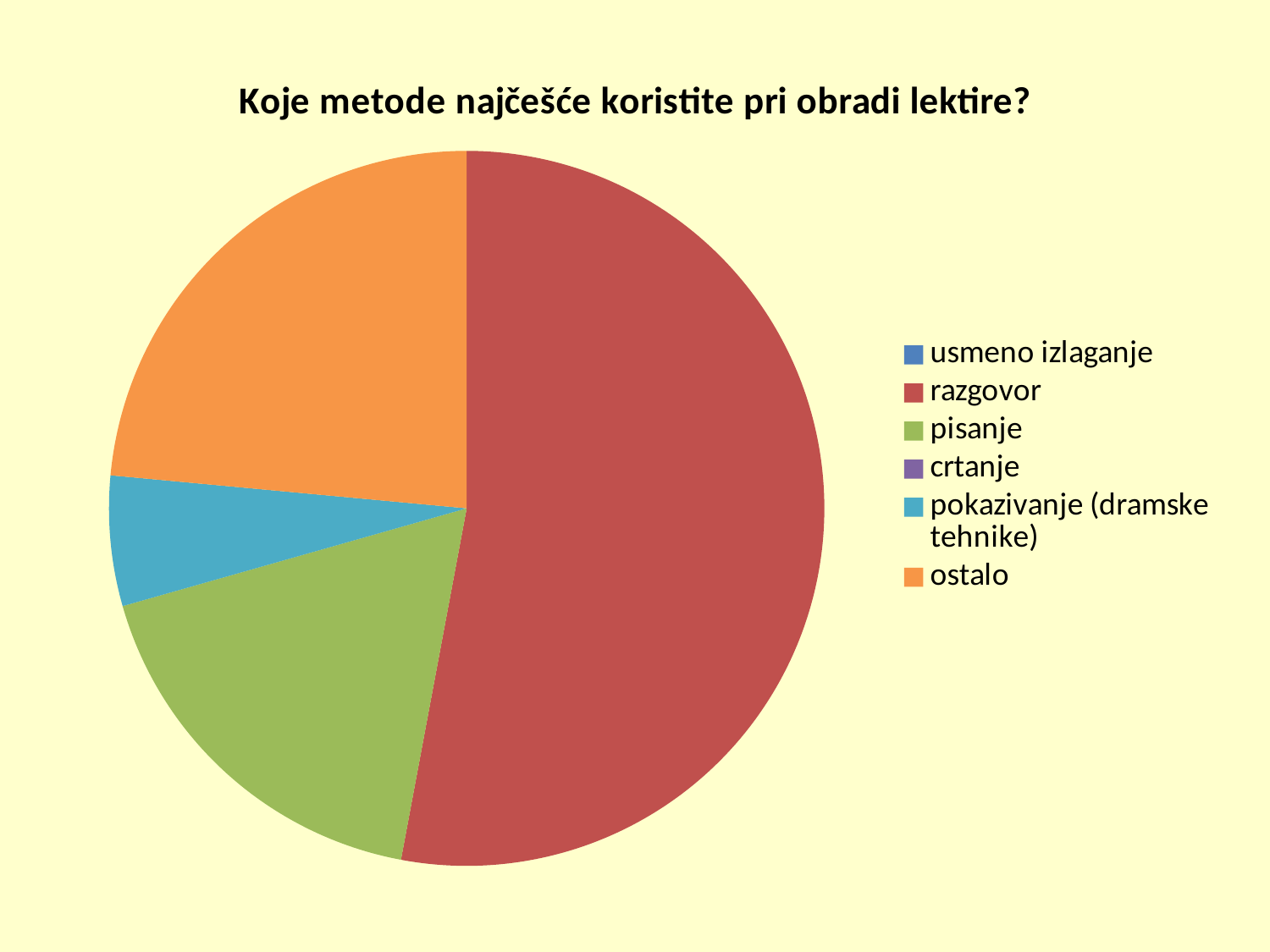
Which slice is larger, pisanje or pokazivanje (dramske tehnike)? pisanje Which colour represents razgovor in the chart? red How many entries does the legend list? 6 Which slice is larger, ostalo or pokazivanje (dramske tehnike)? ostalo What is the title of the chart? Koje metode najčešće koristite pri obradi lektire? What kind of chart is shown on the slide? pie chart Which category has the largest slice of the pie? razgovor Is the share of razgovor greater or less than half of the pie? greater Which slice is larger, razgovor or pisanje? razgovor